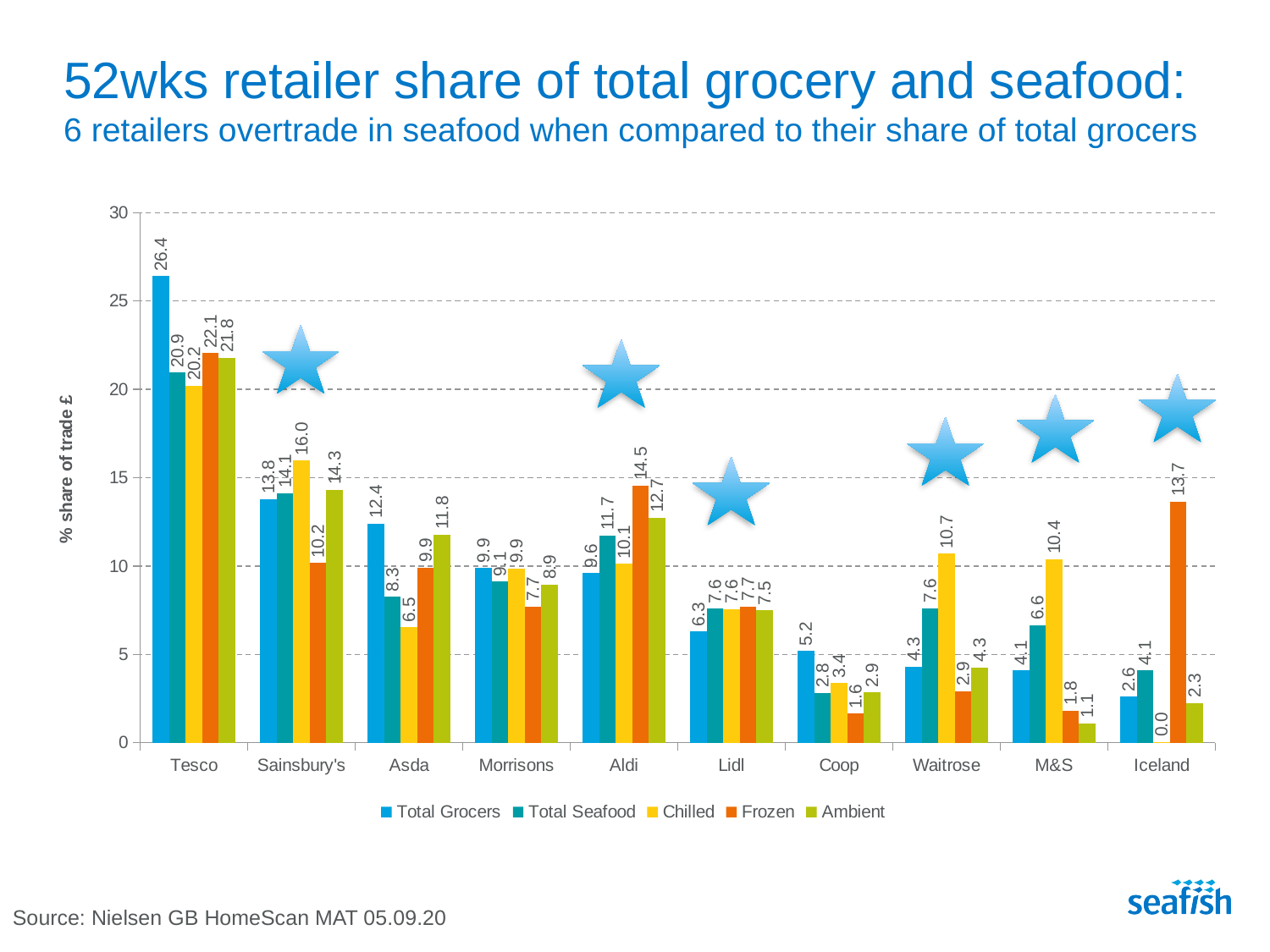
What is the difference between Tesco's Total Grocers share and its Total Seafood share? 5.5 How many series does the legend list? 5 Does the Total Grocers share rise or fall from Tesco to Iceland along the x axis? Fall Which is larger for Aldi: the Frozen share or the Total Grocers share? Frozen What is the label of the y axis? % share of trade £ What kind of chart is shown on the slide? Bar chart What is the Frozen share for Iceland? 13.7 How many retailers are shown on the x axis? 10 Which retailer has the lowest Total Grocers share? Iceland Which retailer has the highest Total Seafood share? Tesco What is the Total Grocers share for Tesco? 26.4 What is the Chilled share for Waitrose? 10.7